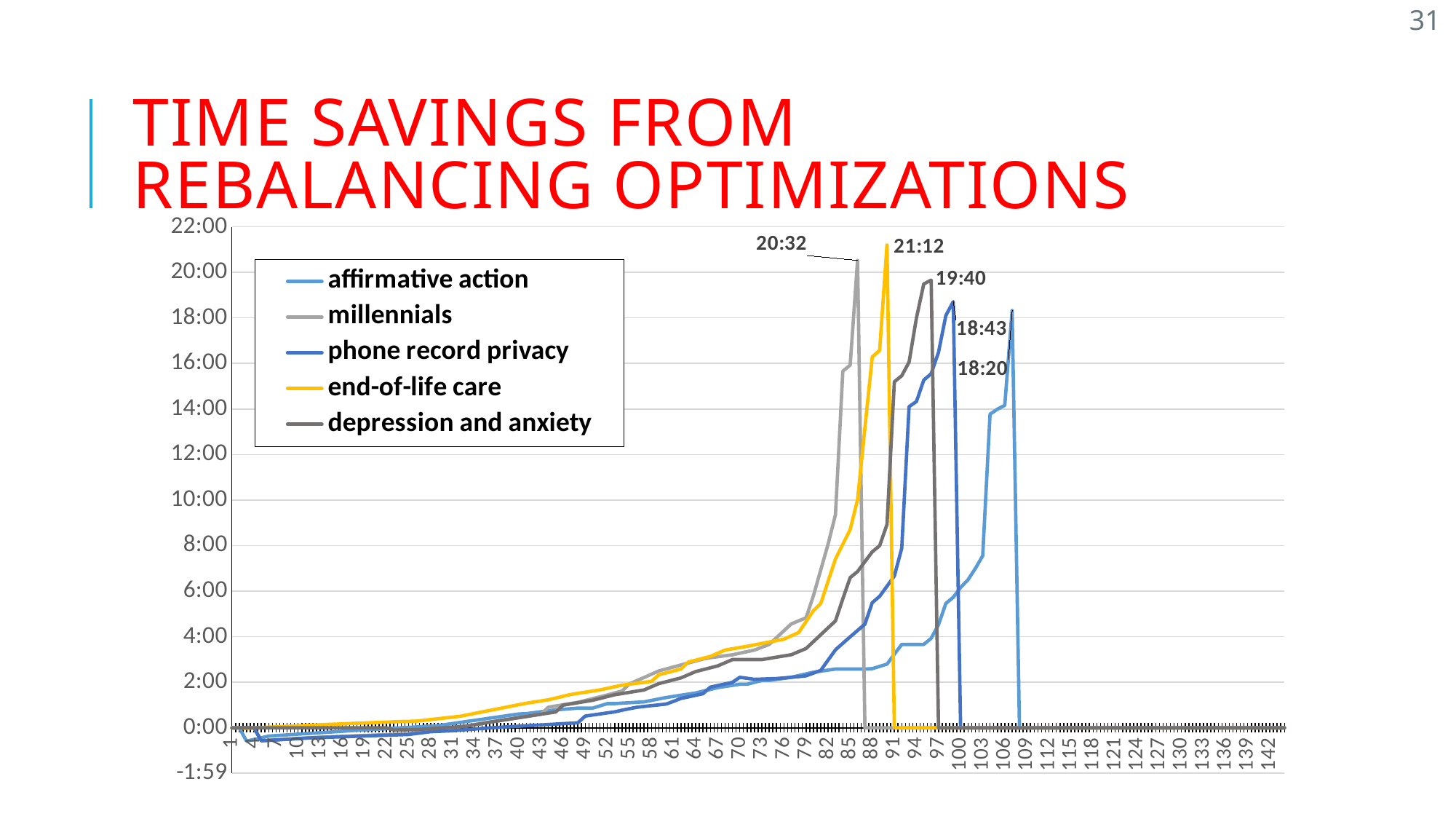
What is the peak value labelled for the depression and anxiety series? 19:40 What is the title of the slide containing the chart? TIME SAVINGS FROM REBALANCING OPTIMIZATIONS What is the difference between the peak values of end-of-life care (21:12) and millennials (20:32)? 0:40 Which series has the larger peak value, millennials or depression and anxiety? millennials Which series has the lowest labelled peak value? affirmative action What is the peak value labelled for the affirmative action series? 18:20 What is the peak value labelled for the end-of-life care series? 21:12 What kind of chart is shown on the slide? line chart Is the peak value of the phone record privacy series greater or less than 20:00? less Which series reaches the highest peak value? end-of-life care How many series does the legend list? 5 What is the peak value labelled for the millennials series? 20:32